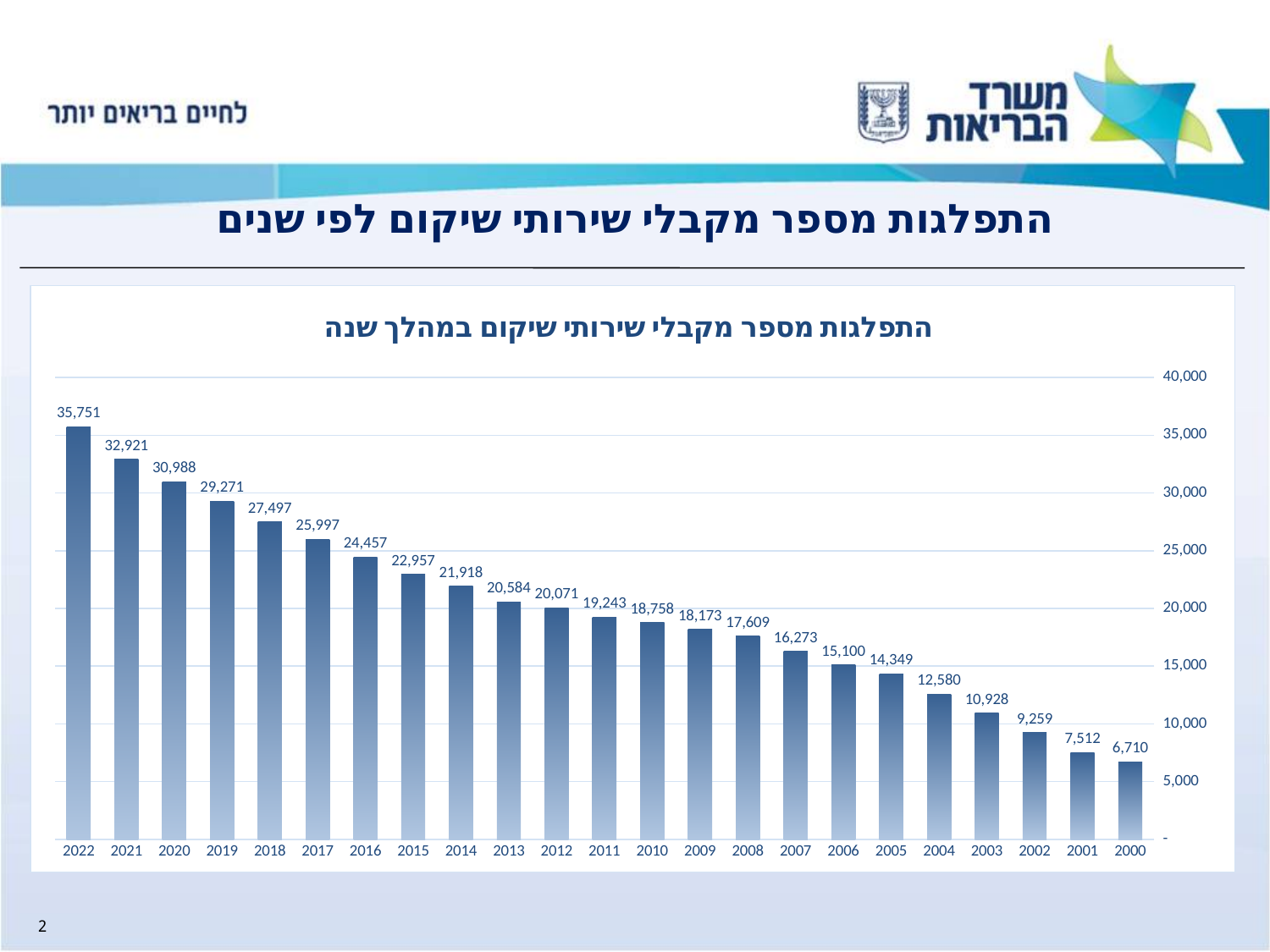
Which year has the lowest value? 2000 Do the values rise or fall moving from 2022 on the left to 2000 on the right? Fall What is the value for 2000? 6,710 How many years are shown on the x axis? 23 What is the difference between the values for 2022 and 2021? 2,830 Which year has the highest value? 2022 What kind of chart is shown on the slide? Bar chart What is the difference between the values for 2005 and 2004? 1,769 Which is larger, the value for 2015 or the value for 2008? 2015 What is the value for 2010? 18,758 What is the value for 2022? 35,751 Is the value for 2007 greater or less than 15,000? greater